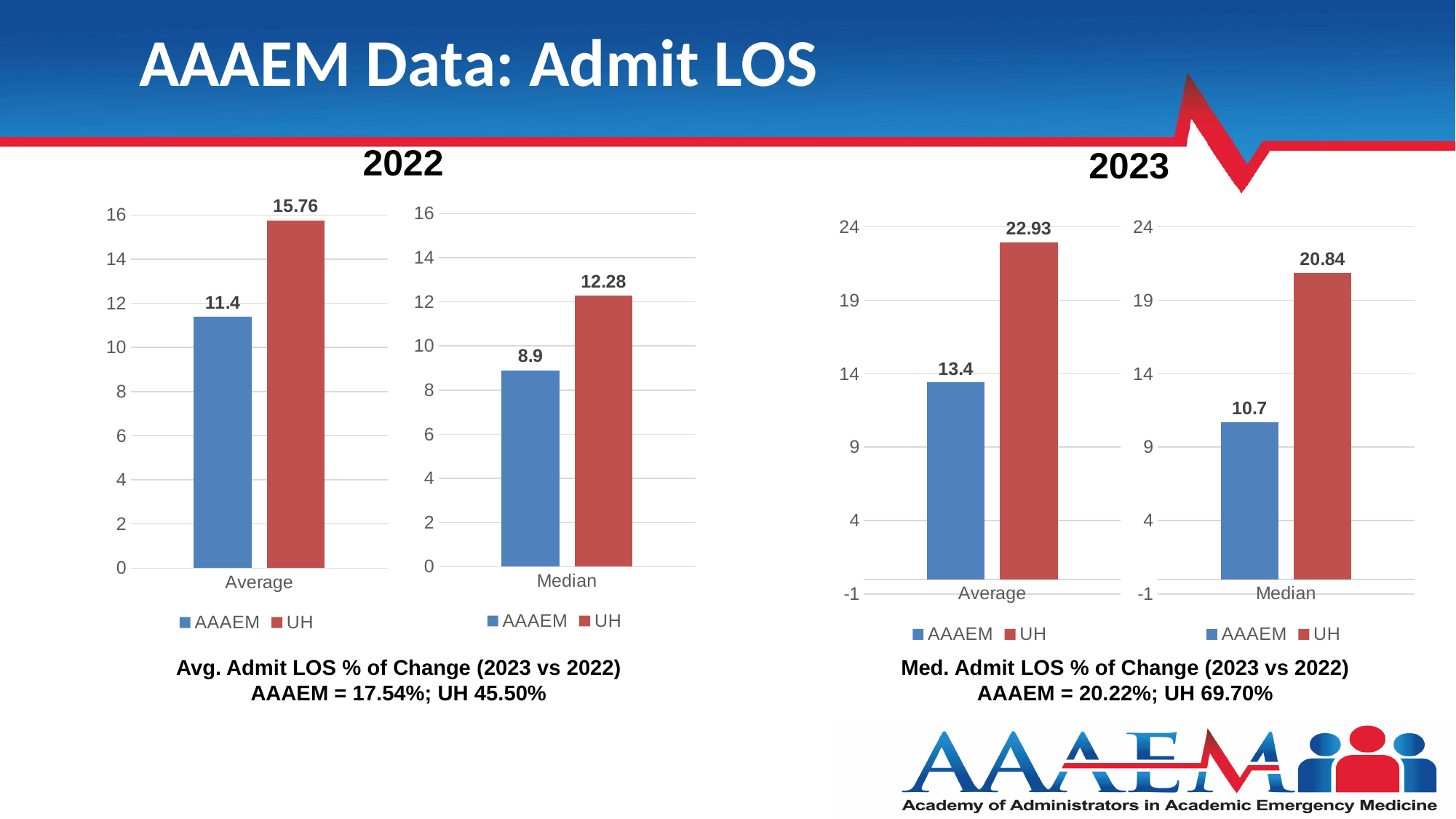
In the 2023 Average chart, what is the value for UH? 22.93 What type of chart is the 2022 Median chart? Bar chart In the 2023 Average chart, which colour represents UH? Red In the 2022 Average chart, what is the value for UH? 15.76 In the 2023 Median chart, what is the value for UH? 20.84 In the 2022 Median chart, what is the difference between the UH and AAAEM values? 3.38 How many series does the legend of the 2023 Average chart list? 2 In the 2023 Median chart, what is the difference between the UH and AAAEM values? 10.14 In the 2023 Average chart, which series has the higher value, AAAEM or UH? UH In the 2022 Average chart, which series has the lowest value? AAAEM In the 2022 Median chart, what is the value for AAAEM? 8.9 In the 2022 Average chart, what is the value for AAAEM? 11.4